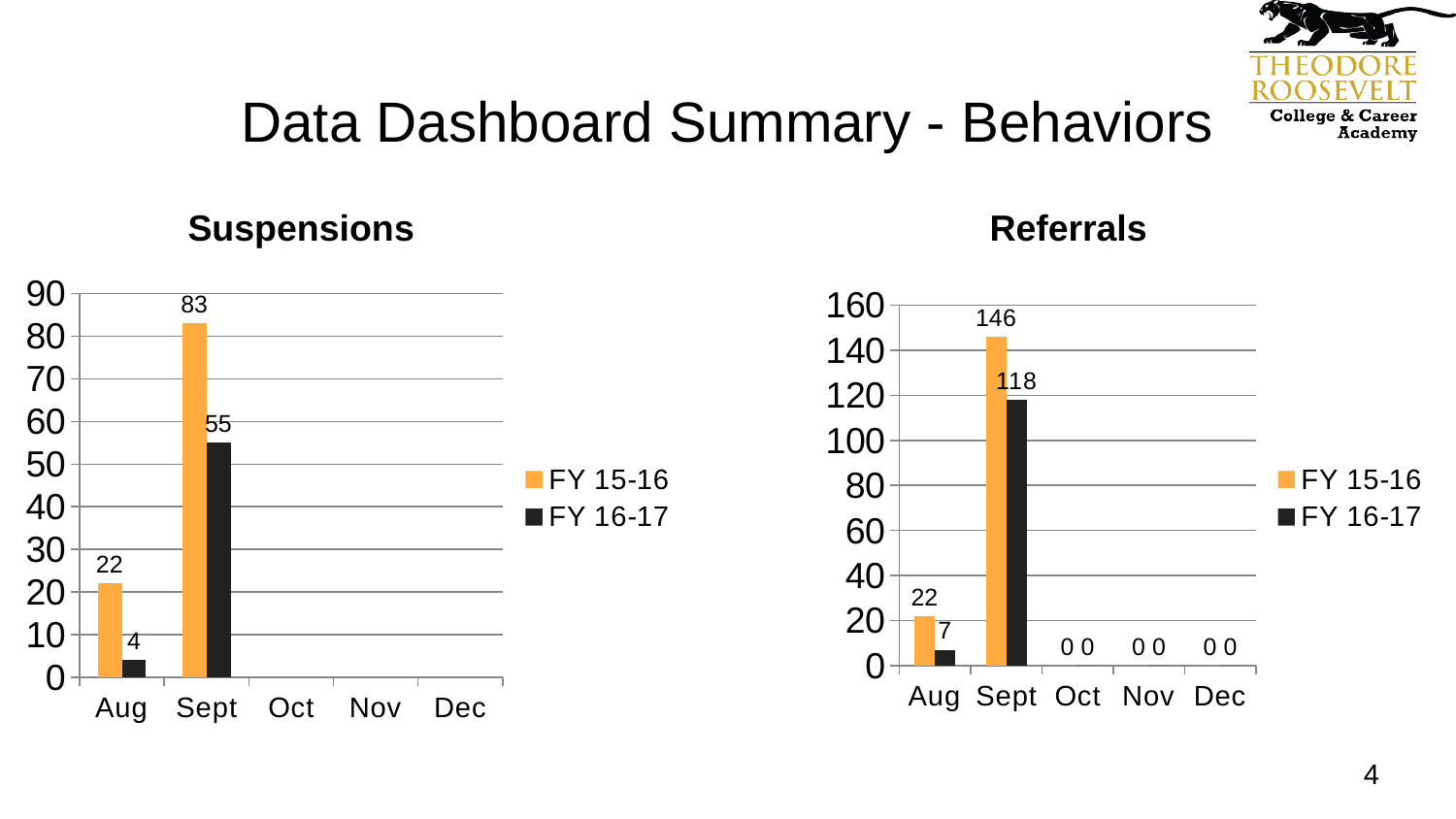
How many series does the legend of the Referrals chart list? 2 In the Referrals chart, which month has the highest FY 15-16 value? Sept In the Suspensions chart, what is the value for FY 16-17 in Aug? 4 In the Referrals chart, what is the value for FY 16-17 in Sept? 118 How many months are shown on the x axis of the Suspensions chart? 5 In the Referrals chart, what is the value for FY 15-16 in Aug? 22 In the Suspensions chart, which is larger in Aug: FY 15-16 or FY 16-17? FY 15-16 What type of chart is the Suspensions chart? Bar chart In the Referrals chart, what is the difference between FY 15-16 and FY 16-17 in Sept? 28 In the Referrals chart, is the FY 15-16 value for Sept greater or less than 140? greater In the Suspensions chart, what is the difference between FY 15-16 and FY 16-17 in Sept? 28 In the Suspensions chart, what is the value for FY 15-16 in Sept? 83